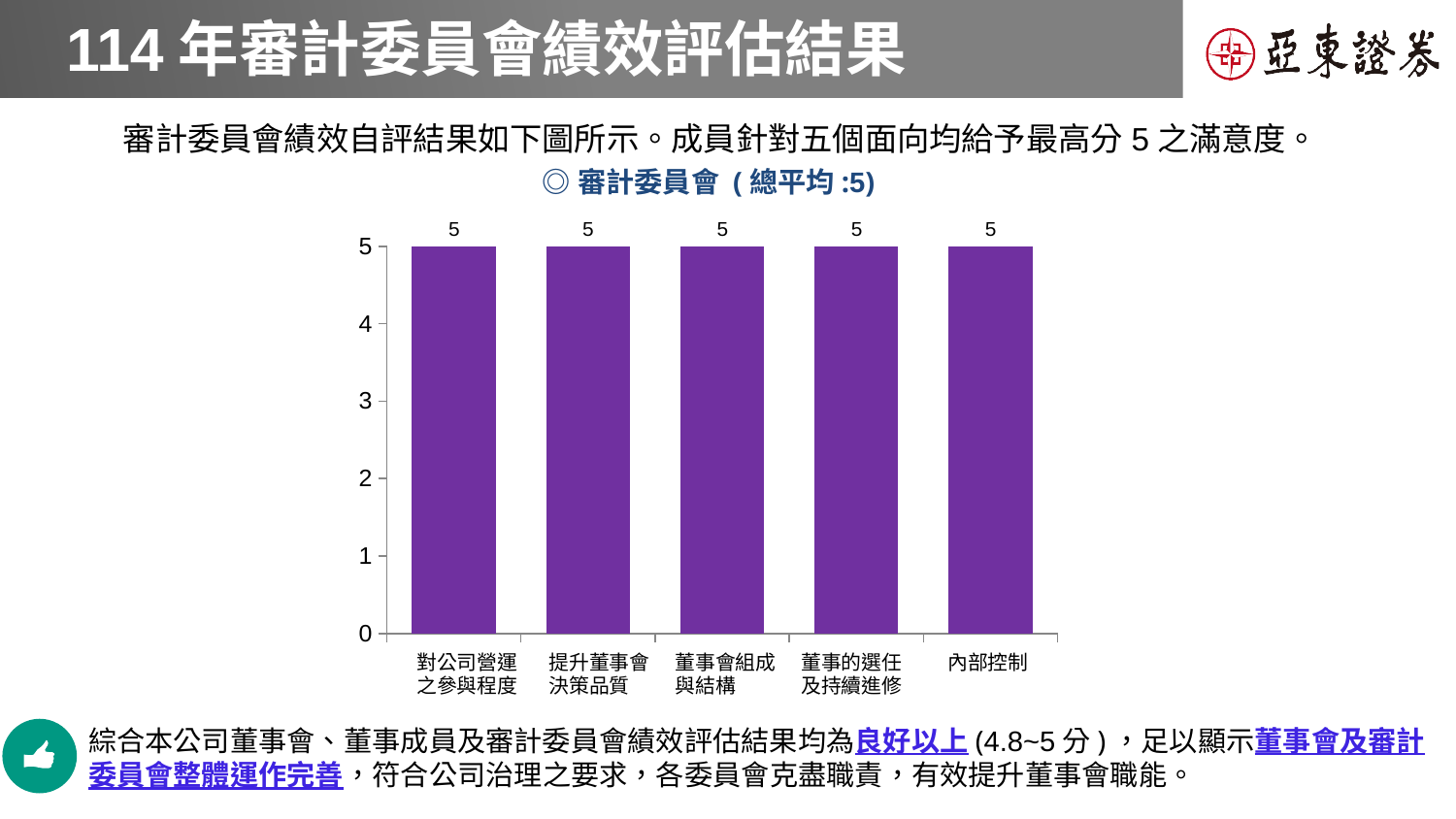
What is the value for 內部控制? 5 What is the title of the chart? 審計委員會（總平均:5） What type of chart is shown on the slide? Bar chart What is the highest value shown on the vertical axis? 5 What is the value for 董事會組成與結構? 5 What is the difference between the values for 內部控制 and 董事會組成與結構? 0 Is the value for 董事的選任及持續進修 greater or less than 4? greater What is the value for 提升董事會決策品質? 5 What is the value for 董事的選任及持續進修? 5 What is the value for 對公司營運之參與程度? 5 How many categories are plotted in the chart? 5 Do the values rise, fall, or stay the same across the categories from left to right? Stay the same